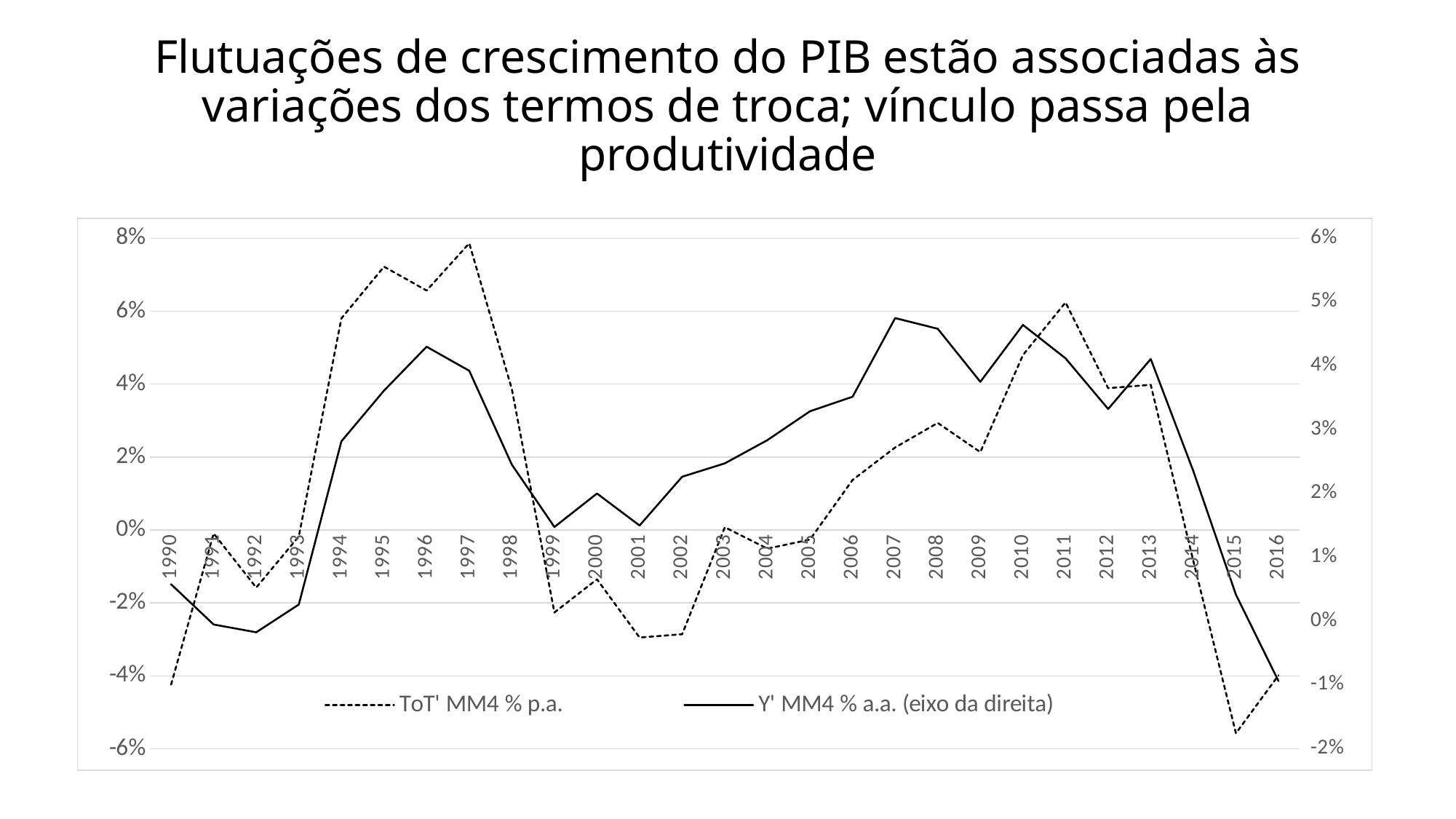
What kind of chart is shown on the slide? line chart In which year does the ToT' MM4 % p.a. series reach its lowest value? 2015 How many series does the legend list? 2 In which year does the Y' MM4 % a.a. series reach its lowest value? 2016 In which year does the ToT' MM4 % p.a. series reach its highest value? 1997 Which series is plotted on the right-hand axis according to the legend? Y' MM4 % a.a. (eixo da direita) How many years are plotted along the x axis? 27 Is the ToT' MM4 % p.a. value for 1997 greater or less than 6%? greater Is the ToT' MM4 % p.a. value for 2015 greater or less than -4%? less Does the ToT' MM4 % p.a. series rise or fall from 2013 to 2015? fall Is the Y' MM4 % a.a. value for 2016 (right axis) greater or less than 0%? less